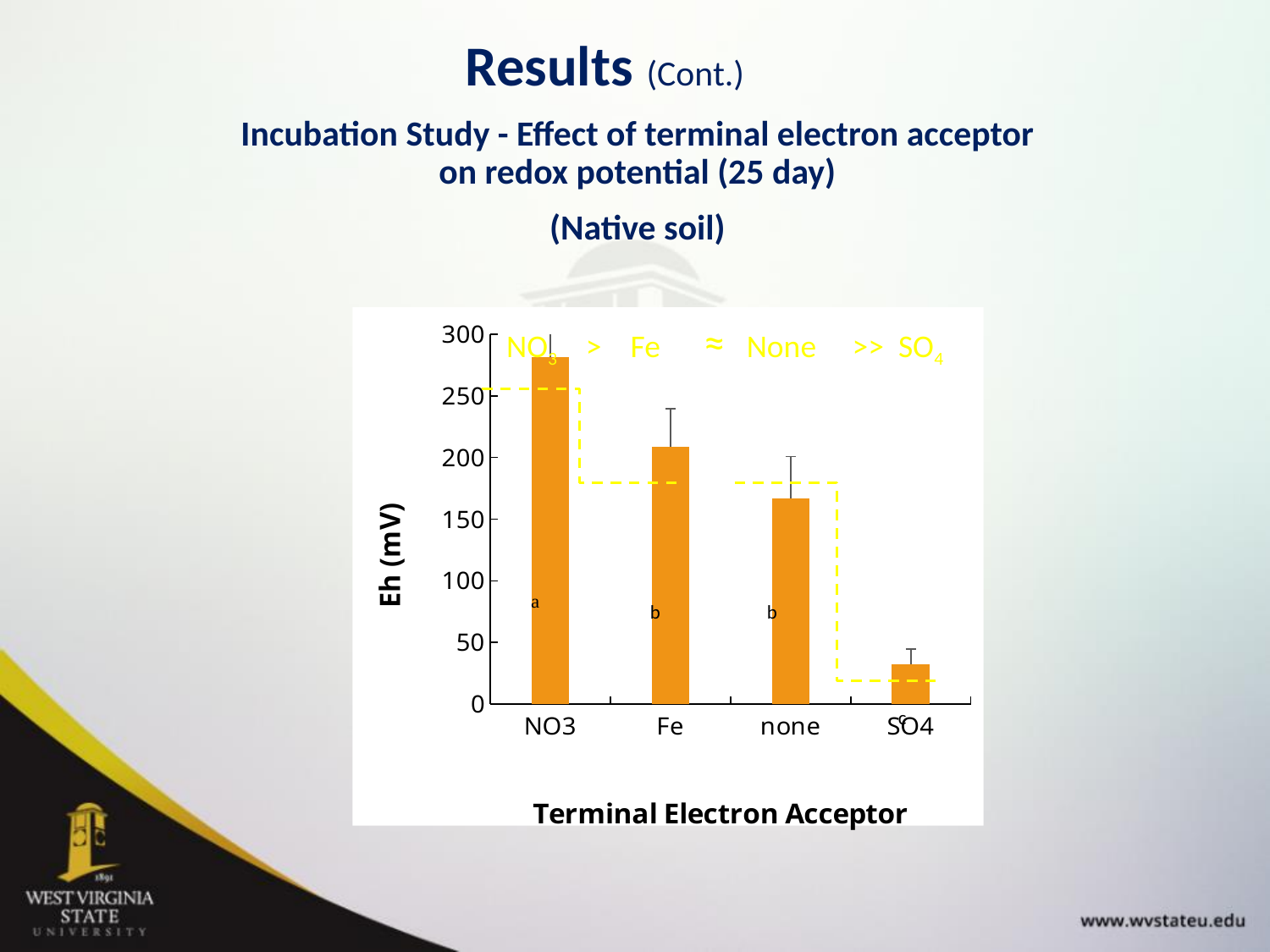
Is the Eh value for Fe greater or less than 150 mV? greater Which terminal electron acceptor has the lowest Eh value? SO4 How many terminal electron acceptor categories are plotted on the x axis? 4 Which has a larger Eh value, none or SO4? none What is the label of the y axis? Eh (mV) Which has a larger Eh value, NO3 or Fe? NO3 Is the Eh value for SO4 greater or less than 50 mV? less Is the Eh value for none greater or less than 200 mV? less Do the Eh values rise or fall moving from NO3 to SO4 along the x axis? fall Which terminal electron acceptor has the highest Eh value? NO3 What kind of chart is shown on the slide? bar chart